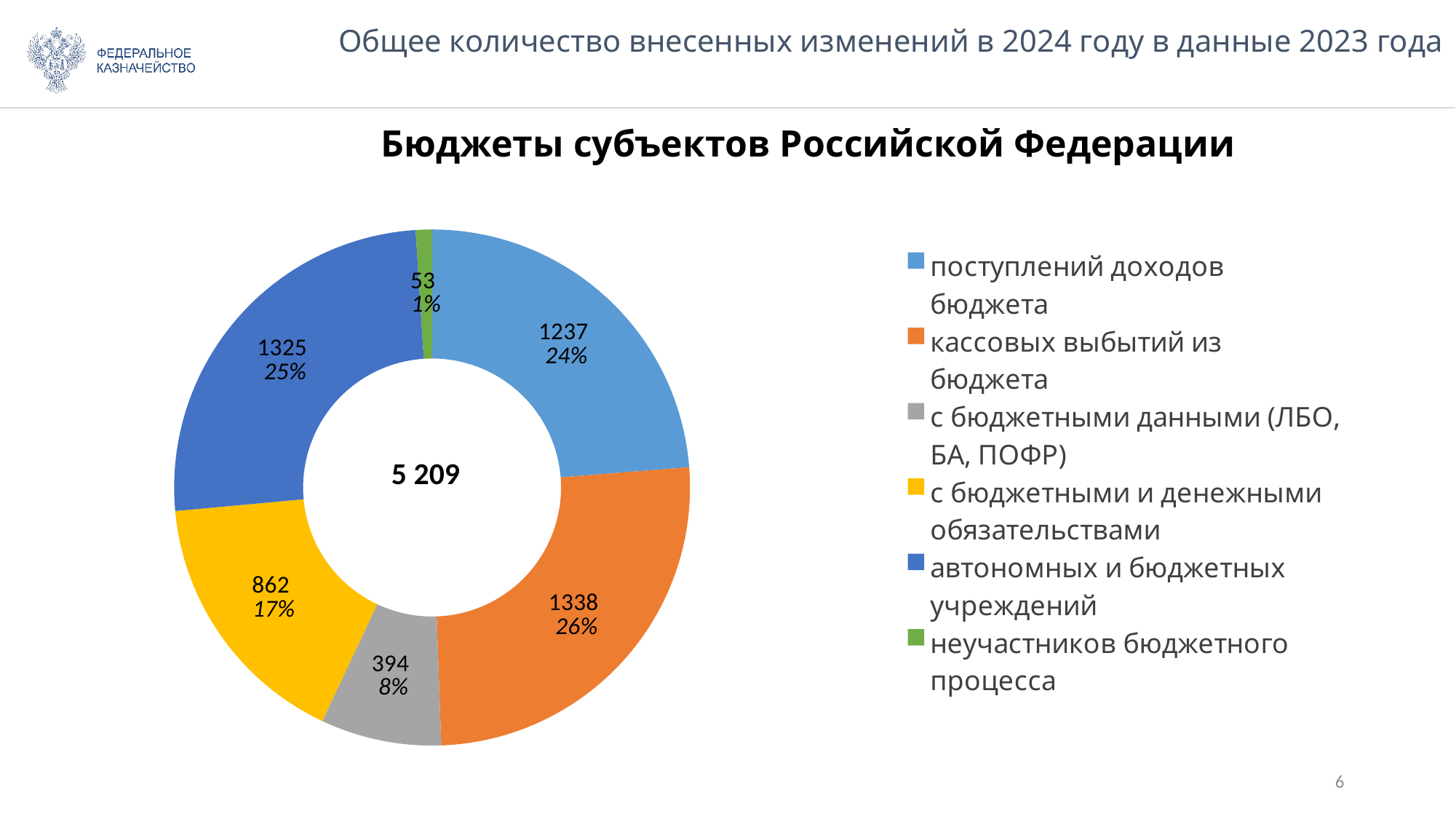
Which is larger: the value for "с бюджетными и денежными обязательствами" or for "с бюджетными данными (ЛБО, БА, ПОФР)"? с бюджетными и денежными обязательствами What is the difference between the values for "кассовых выбытий из бюджета" and "автономных и бюджетных учреждений"? 13 What is the value for "кассовых выбытий из бюджета"? 1338 How many categories does the chart show? 6 What is the value for "с бюджетными данными (ЛБО, БА, ПОФР)"? 394 What is the value for "поступлений доходов бюджета"? 1237 Which category has the largest value? кассовых выбытий из бюджета What kind of chart is shown on the slide? Donut (pie) chart Which category has the smallest value? неучастников бюджетного процесса What percentage share does "с бюджетными и денежными обязательствами" have? 17% What percentage share does "автономных и бюджетных учреждений" have? 25% What total is shown in the centre of the chart? 5 209